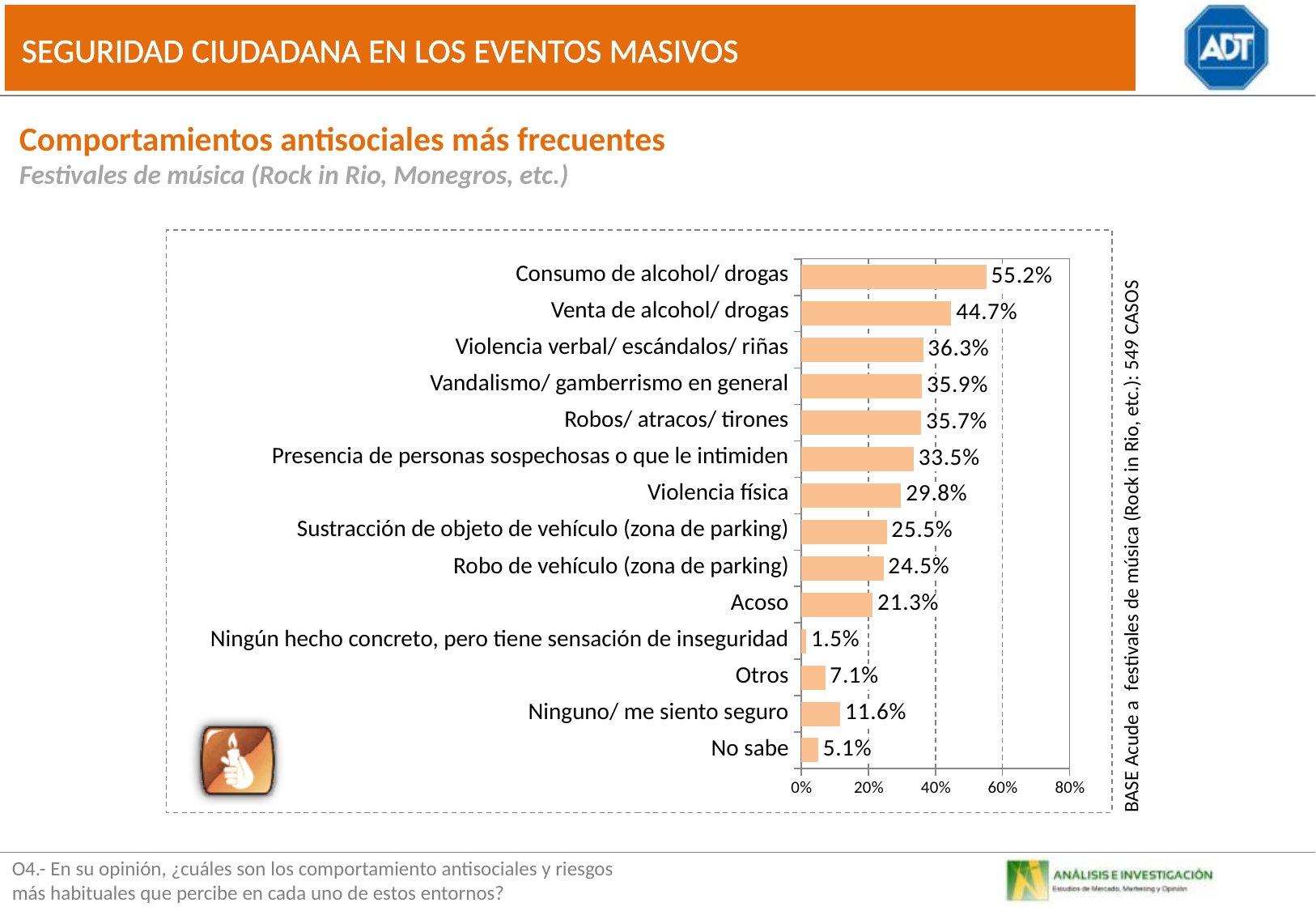
What is the value for Consumo de alcohol/ drogas? 55.2% What is the value for Acoso? 21.3% What is the difference between Consumo de alcohol/ drogas and Venta de alcohol/ drogas? 10.5% What is the value for Ninguno/ me siento seguro? 11.6% How many categories are shown in the chart? 14 What is the title of the chart section on the slide? Comportamientos antisociales más frecuentes What kind of chart is shown on the slide? bar chart What is the difference between Otros and No sabe? 2% Which category has the highest value? Consumo de alcohol/ drogas Is the value for Venta de alcohol/ drogas greater or less than 40%? greater Which category has the lowest value? Ningún hecho concreto, pero tiene sensación de inseguridad Which is larger, Violencia física or Robo de vehículo (zona de parking)? Violencia física